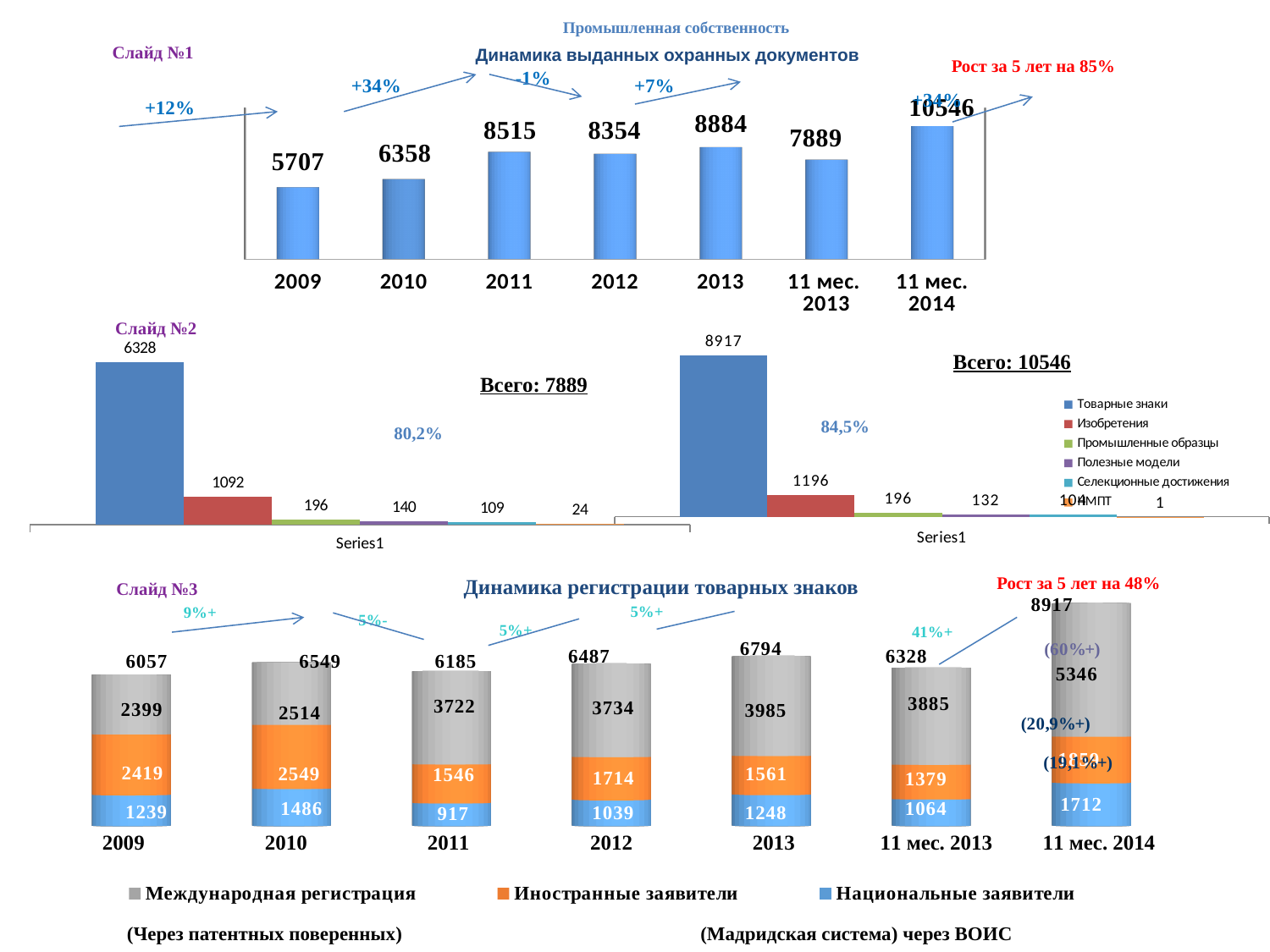
In the top chart 'Динамика выданных охранных документов', what is the difference between the values for 11 мес. 2014 and 11 мес. 2013? 2657 In the top chart 'Динамика выданных охранных документов', what is the value for 2011? 8515 In the middle-left chart (Всего: 7889), what is the value of the Изобретения bar? 1092 In the bottom chart 'Динамика регистрации товарных знаков', what is the total of the stacked bar for 2013? 6794 How many categories are shown on the x axis of the top chart 'Динамика выданных охранных документов'? 7 In the bottom chart 'Динамика регистрации товарных знаков', what is the Национальные заявители value for 2012? 1039 In the top chart 'Динамика выданных охранных документов', which category has the highest value? 11 мес. 2014 In the top chart 'Динамика выданных охранных документов', which category has the lowest value? 2009 In the middle-right chart (Всего: 10546), what is the value of the Товарные знаки bar? 8917 In the middle-right chart (Всего: 10546), which is larger: Промышленные образцы or Полезные модели? Промышленные образцы How many series does the legend of the bottom chart 'Динамика регистрации товарных знаков' list? 3 What kind of chart is the bottom chart 'Динамика регистрации товарных знаков'? Stacked bar chart